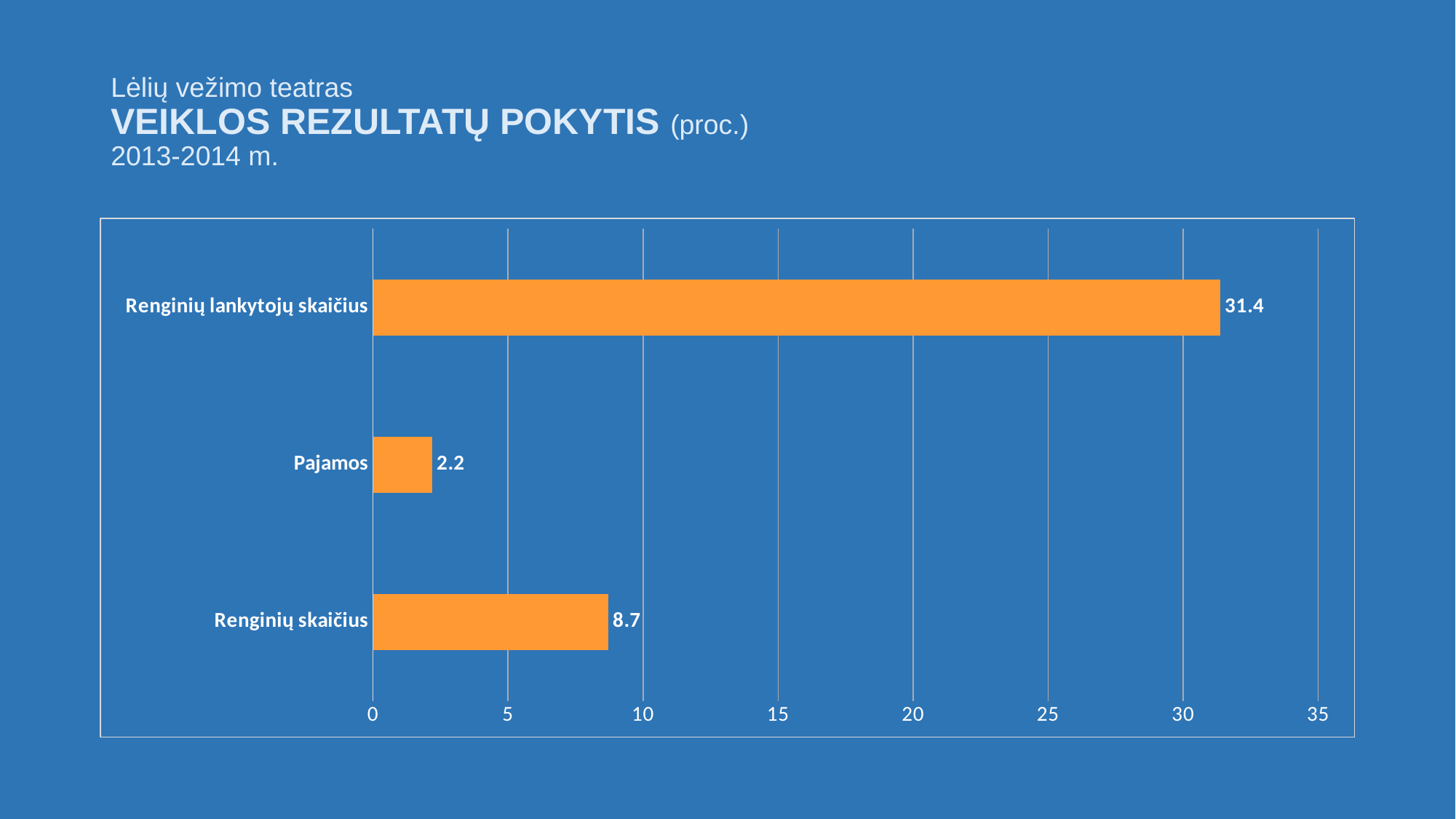
Which category has the lowest value? Pajamos What is the maximum value shown on the horizontal axis? 35 Which category has the highest value? Renginių lankytojų skaičius What is the difference between the values for Renginių lankytojų skaičius and Renginių skaičius? 22.7 What is the value for Pajamos? 2.2 What kind of chart is shown on the slide? Bar chart Which is larger, the value for Renginių skaičius or the value for Pajamos? Renginių skaičius What is the value for Renginių skaičius? 8.7 What is the value for Renginių lankytojų skaičius? 31.4 How many categories are shown in the chart? 3 Is the value for Renginių lankytojų skaičius greater or less than 30? greater What is the difference between the values for Renginių skaičius and Pajamos? 6.5